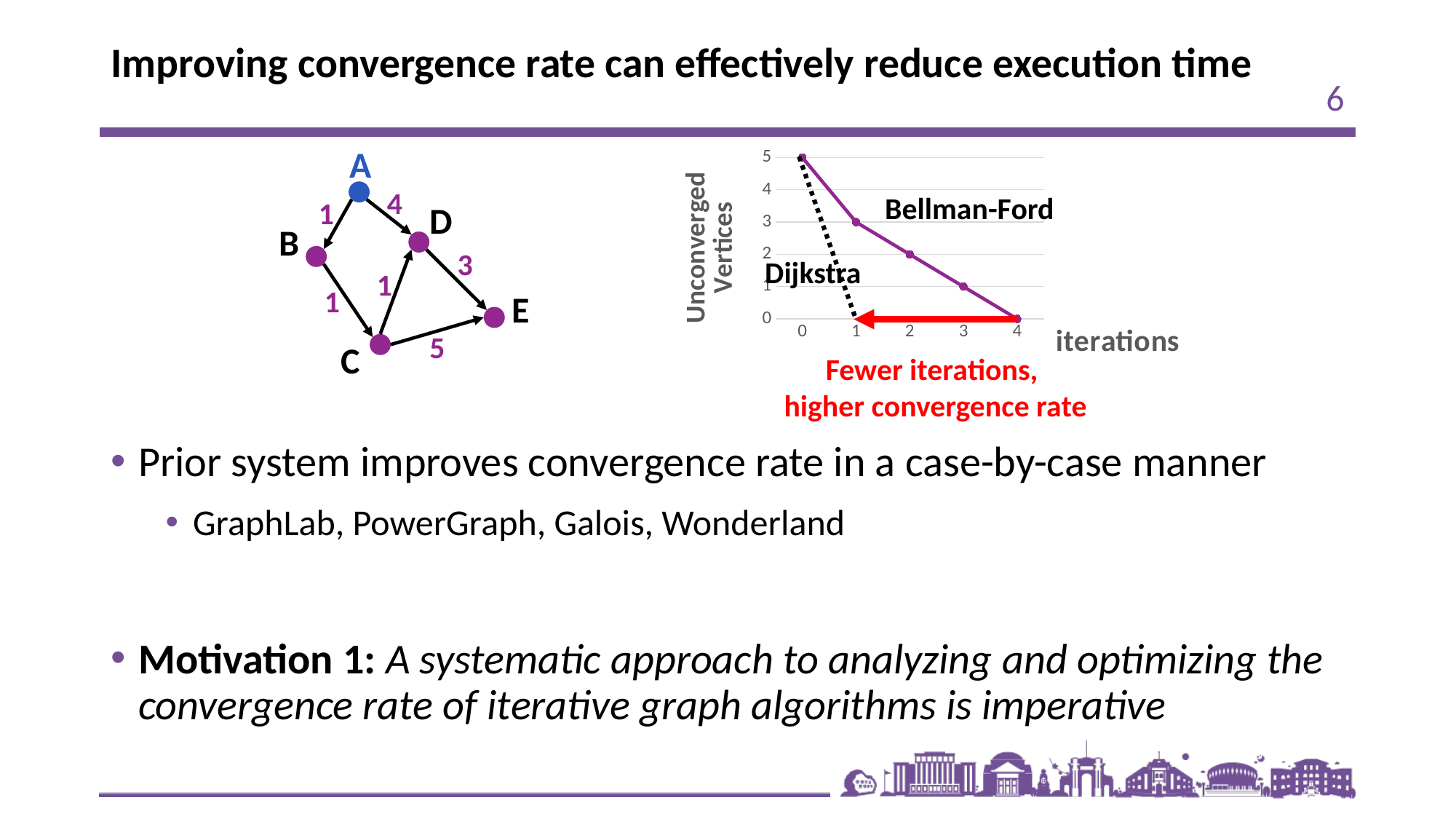
In the line chart, at which iteration does Bellman-Ford reach 0 unconverged vertices? 4 In the line chart, how many unconverged vertices does Bellman-Ford have at iteration 2? 2 How many data points are plotted on the Bellman-Ford line in the line chart? 5 In the line chart, at which iteration does Dijkstra reach 0 unconverged vertices? 1 What kind of chart is shown on the right side of the slide? line chart What is the label of the y-axis in the line chart? Unconverged Vertices In the line chart, how many unconverged vertices does Bellman-Ford have at iteration 0? 5 In the line chart, which algorithm has more unconverged vertices at iteration 1, Bellman-Ford or Dijkstra? Bellman-Ford In the line chart, what is the difference in unconverged vertices between Bellman-Ford and Dijkstra at iteration 1? 3 In the line chart, how many unconverged vertices does Bellman-Ford have at iteration 1? 3 How many lines (algorithms) are plotted in the line chart? 2 In the line chart, do the unconverged vertices for Bellman-Ford rise or fall as iterations increase? fall